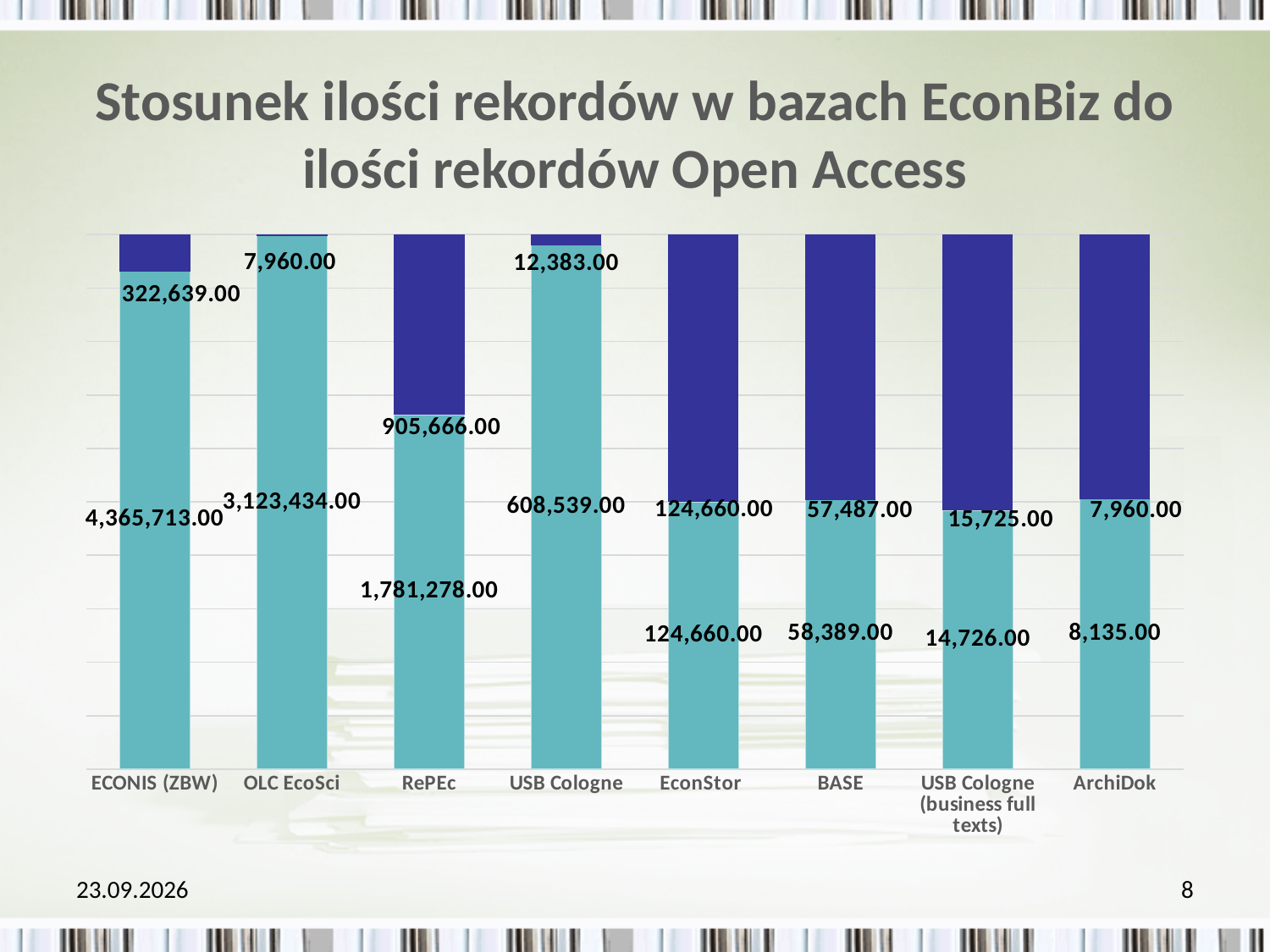
Which category has the largest teal (lower) segment value? ECONIS (ZBW) What kind of chart is shown on the slide? Stacked bar chart What is the total of the two segments for ECONIS (ZBW)? 4,688,352.00 Which category has the smallest teal (lower) segment value? ArchiDok What is the value of the teal (lower) segment for ECONIS (ZBW)? 4,365,713.00 What is the difference between the teal (lower) and dark blue (upper) segment values for RePEc? 875,612.00 How many categories are shown along the x axis of the chart? 8 What is the title of the slide containing the chart? Stosunek ilości rekordów w bazach EconBiz do ilości rekordów Open Access What is the value of the dark blue (upper) segment for ArchiDok? 7,960.00 For BASE, which is larger: the teal (lower) segment value or the dark blue (upper) segment value? Teal (lower) segment What is the value of the dark blue (upper) segment for RePEc? 905,666.00 What is the value of the teal (lower) segment for EconStor? 124,660.00